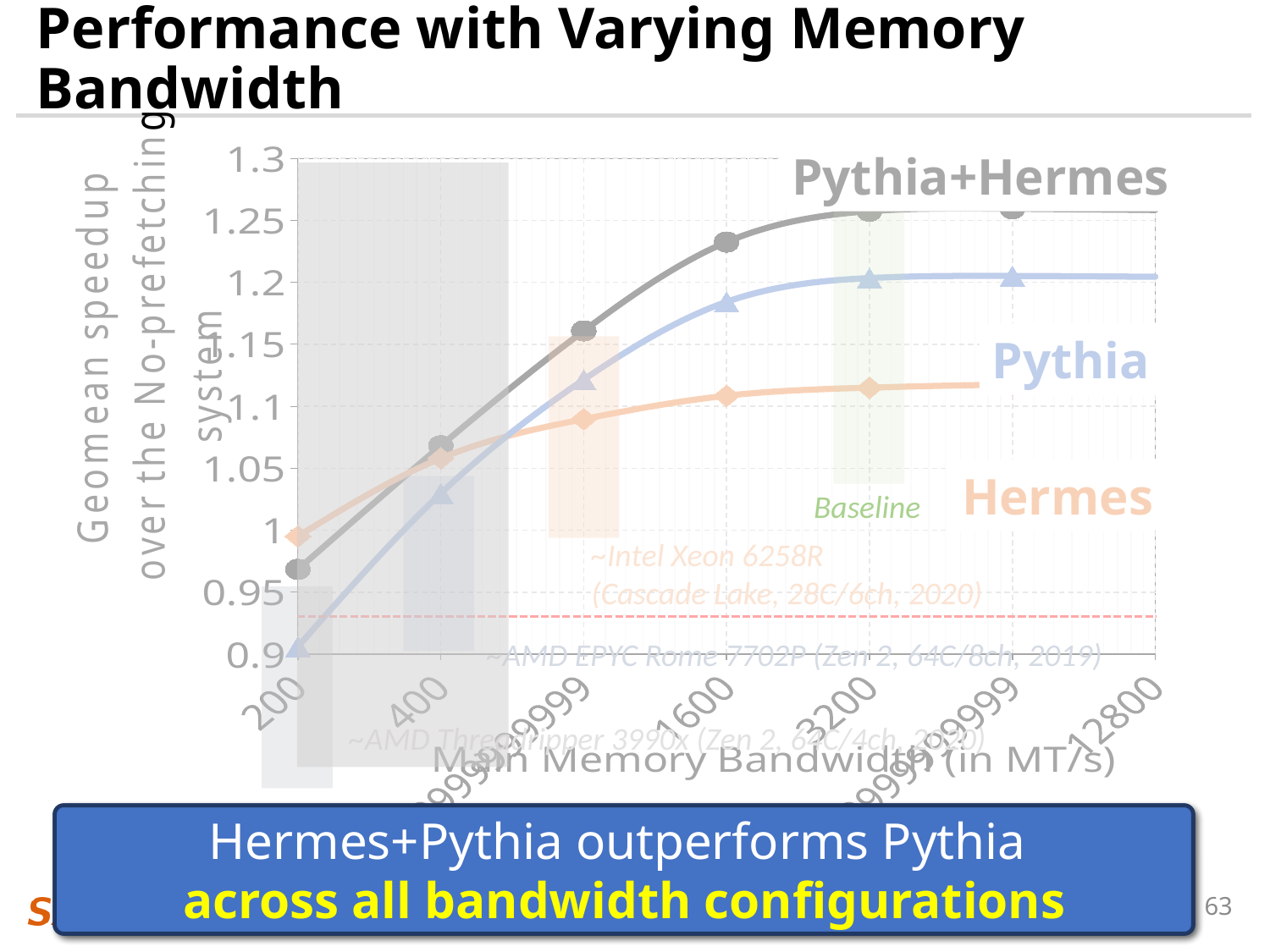
Which series has the lowest speedup at 200 MT/s? Pythia At 1600 MT/s, which has the higher speedup: Pythia+Hermes or Pythia? Pythia+Hermes Is the value for Pythia+Hermes at 1600 MT/s greater or less than 1.2? greater How many data series are plotted in the chart? 3 What kind of chart is shown on the slide? line chart At 200 MT/s, which has the higher speedup: Hermes or Pythia? Hermes Is the value for Hermes at 3200 MT/s greater or less than 1.15? less Is the value for Pythia+Hermes at 200 MT/s greater or less than 1? less Does the Pythia+Hermes series rise or fall as main memory bandwidth increases along the x axis? rise Which series has the highest speedup at 3200 MT/s? Pythia+Hermes What is the title of the x axis? Main Memory Bandwidth (in MT/s)